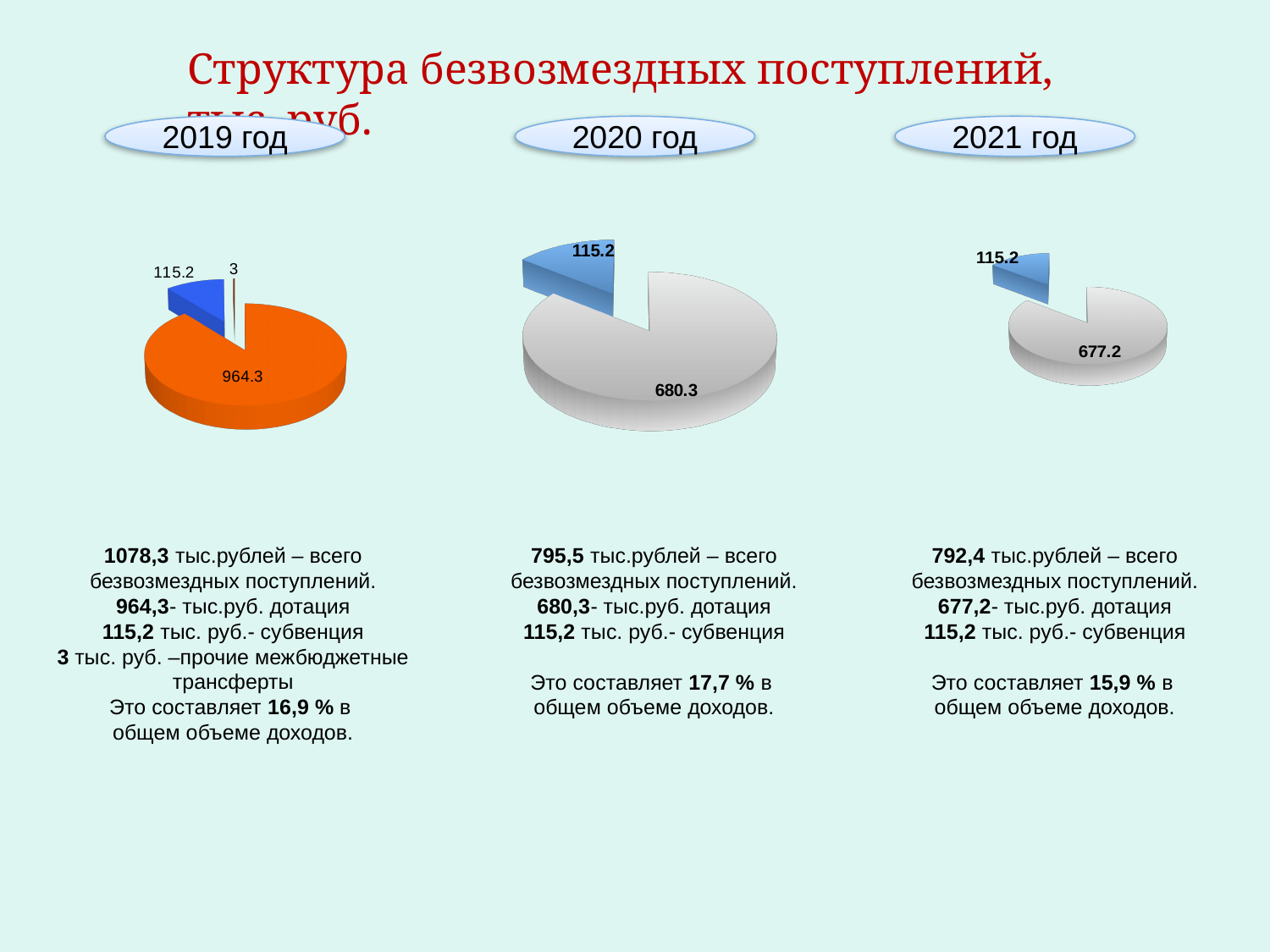
In the 2021 год pie chart, what is the value of the grey slice? 677.2 In the 2021 год pie chart, which slice is larger, the one labelled 677.2 or the one labelled 115.2? 677.2 How many slices does the 2020 год pie chart have? 2 In the 2020 год pie chart, what is the value of the grey slice? 680.3 What kind of chart is shown for 2019 год? pie chart What is the difference between the two slices in the 2020 год pie chart (680.3 and 115.2)? 565.1 In the 2019 год pie chart, what is the value of the largest slice? 964.3 What colour is the largest slice in the 2019 год pie chart? orange In the 2019 год pie chart, what is the value of the smallest slice? 3 How many slices does the 2019 год pie chart have? 3 What is the total of the slices in the 2021 год pie chart? 792.4 In the 2020 год pie chart, what is the value of the blue slice? 115.2